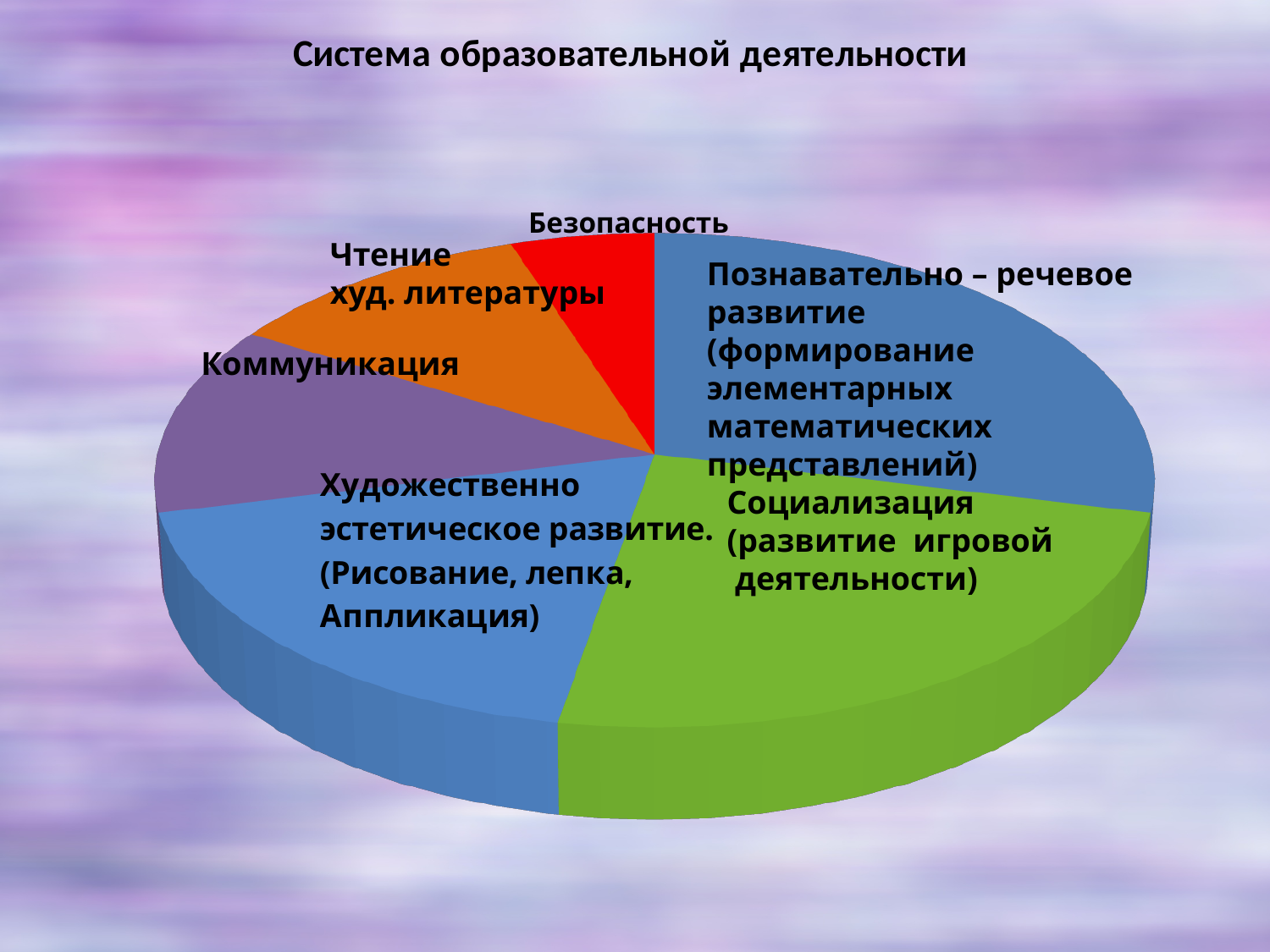
What kind of chart is shown on the slide? pie chart Which slice is larger: Безопасность or Коммуникация? Коммуникация How many slices does the pie chart have? 6 Which slice is larger: Безопасность or Социализация (развитие игровой деятельности)? Социализация (развитие игровой деятельности) Which slice is larger: Коммуникация or Познавательно – речевое развитие? Познавательно – речевое развитие What colour is the Безопасность slice? red Which category has the smallest slice in the pie chart? Безопасность What is the title of the slide? Система образовательной деятельности